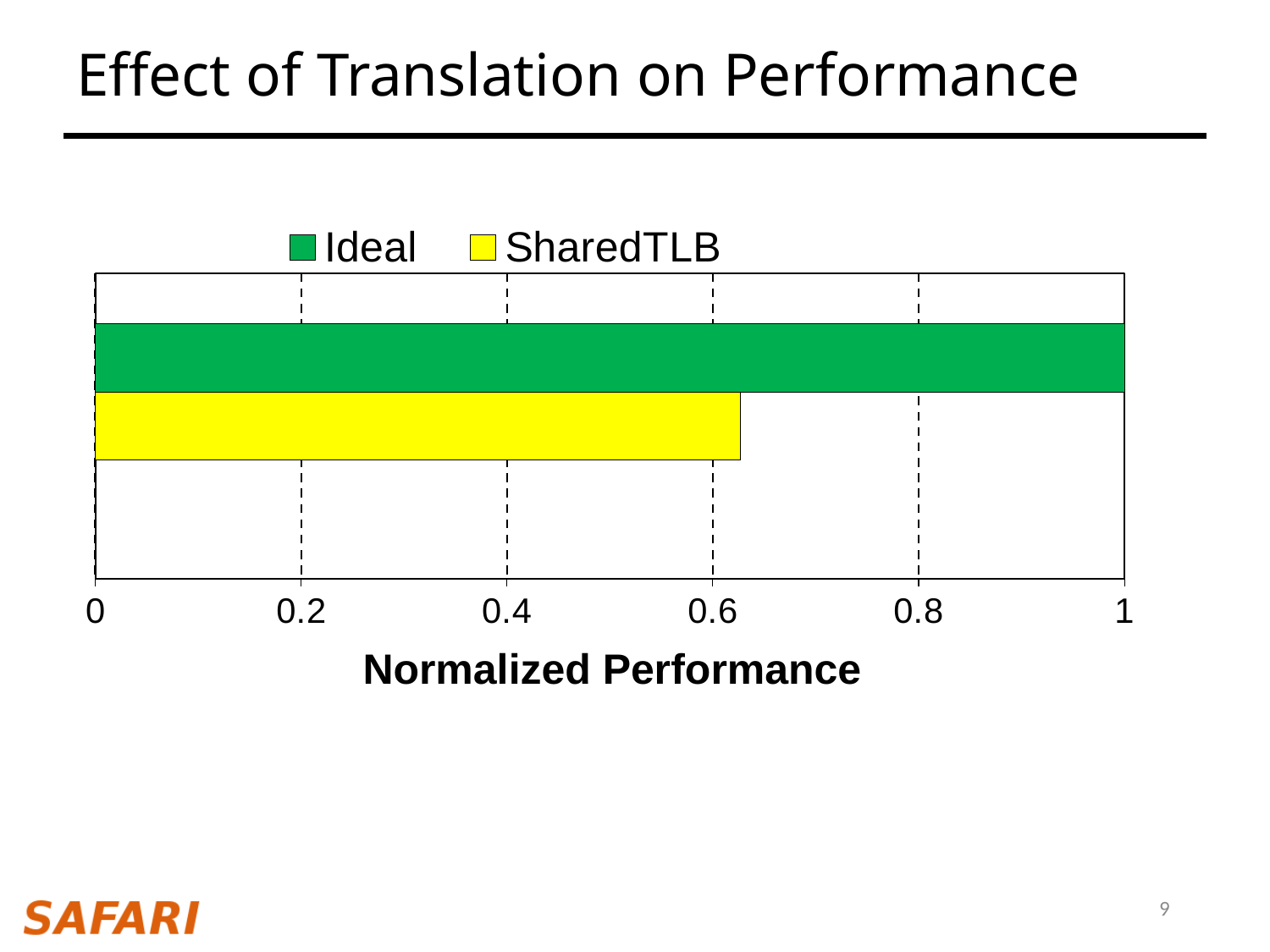
Which series has the highest normalized performance? Ideal Is the value for SharedTLB greater or less than 0.8? less What is the label of the horizontal axis? Normalized Performance What are the two series named in the legend? Ideal and SharedTLB How many bars are plotted in the chart? 2 What kind of chart is shown on the slide? bar chart Is the value for SharedTLB greater or less than 0.6? greater Which series has the lowest normalized performance? SharedTLB Is the value for Ideal greater or less than 0.8? greater What is the normalized performance value for Ideal? 1 How many series does the legend list? 2 Which series has the higher normalized performance, Ideal or SharedTLB? Ideal